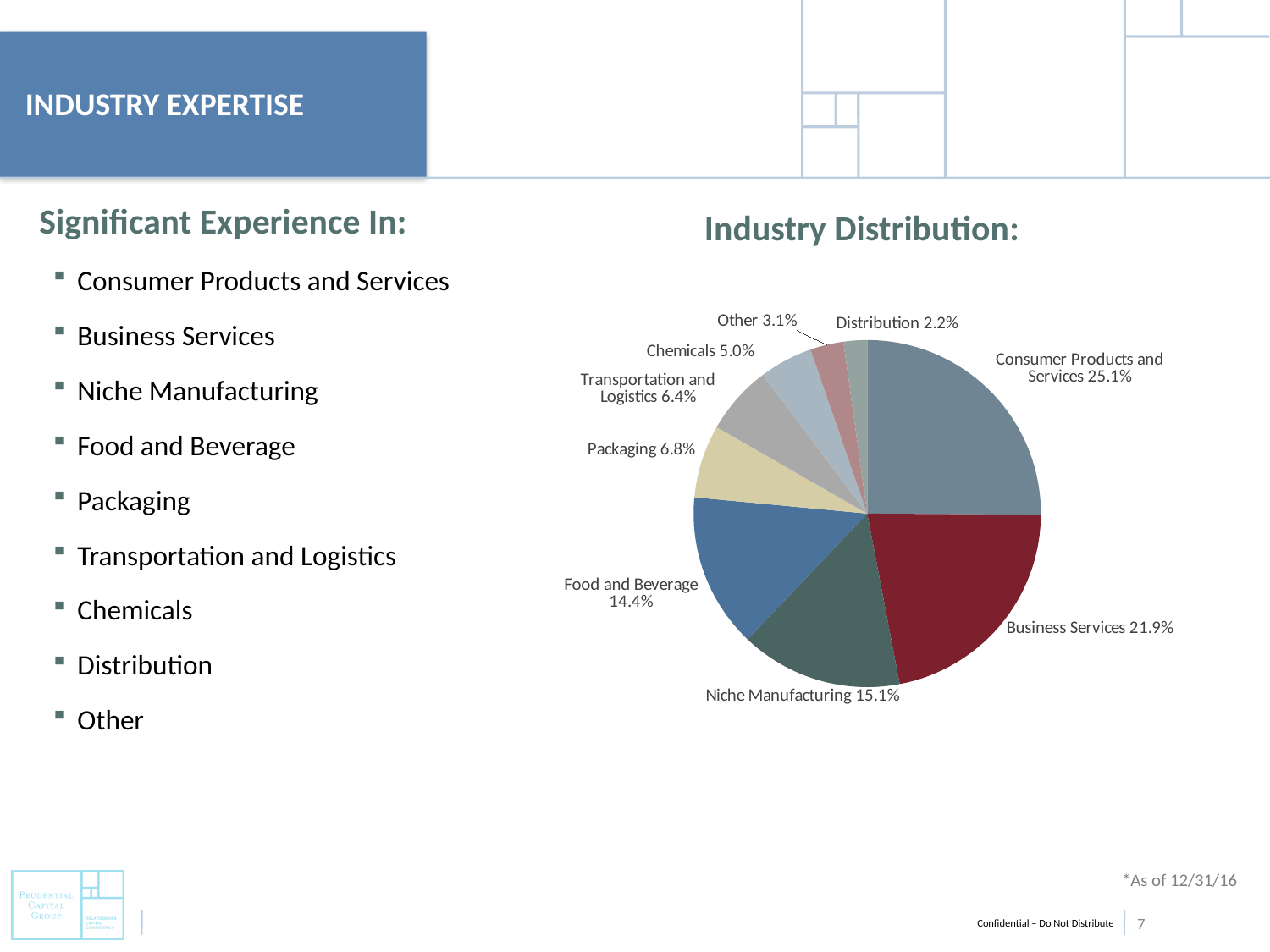
What is the value for Niche Manufacturing? 15.1% Which category has the largest slice of the pie? Consumer Products and Services What is the value for Transportation and Logistics? 6.4% What is the title of the chart? Industry Distribution: How many slices does the pie chart have? 9 Which is larger, Food and Beverage or Niche Manufacturing? Niche Manufacturing What is the difference between Packaging and Chemicals? 1.8% What kind of chart is shown on the slide? pie chart What is the difference between Consumer Products and Services and Business Services? 3.2% What share of the pie does Consumer Products and Services hold? 25.1% What is the value for Business Services? 21.9% Which category has the smallest slice of the pie? Distribution